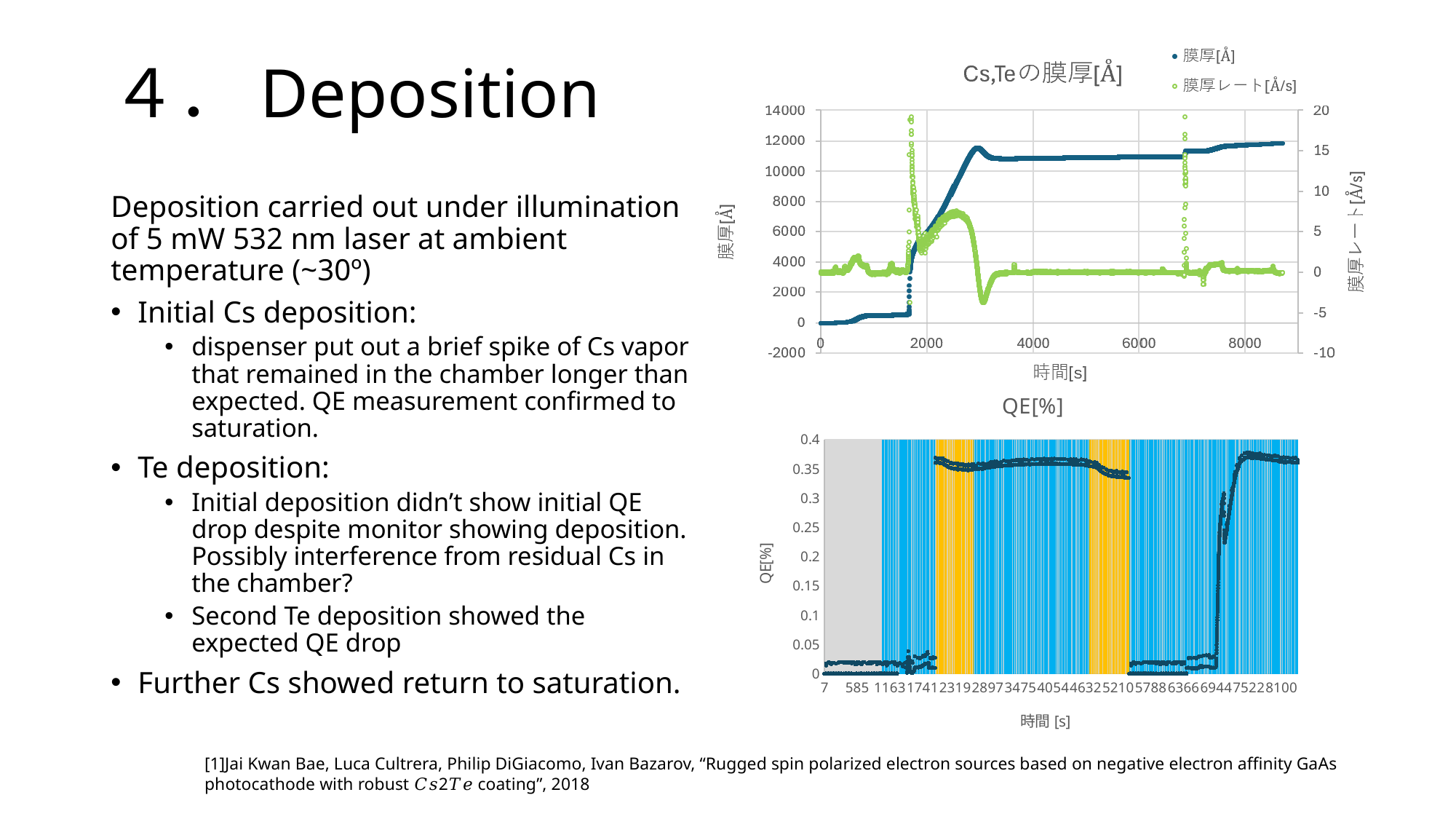
In the bottom chart "QE[%]", is the QE value at time 585 greater or less than 0.05? less In the top chart "Cs,Teの膜厚[Å]", what is the label of the x axis? 時間[s] In the bottom chart "QE[%]", is the QE value at time 5788 greater or less than 0.1? less What kind of chart is the top chart titled "Cs,Teの膜厚[Å]"? scatter (line) chart In the top chart "Cs,Teの膜厚[Å]", what is the highest tick shown on the left y axis? 14000 In the top chart "Cs,Teの膜厚[Å]", is the 膜厚[Å] value at 1000 s greater or less than 2000? less In the top chart "Cs,Teの膜厚[Å]", does the 膜厚[Å] series overall rise or fall from 0 s to 8000 s? rise What is the title of the bottom chart? QE[%] How many series does the legend of the top chart "Cs,Teの膜厚[Å]" list? 2